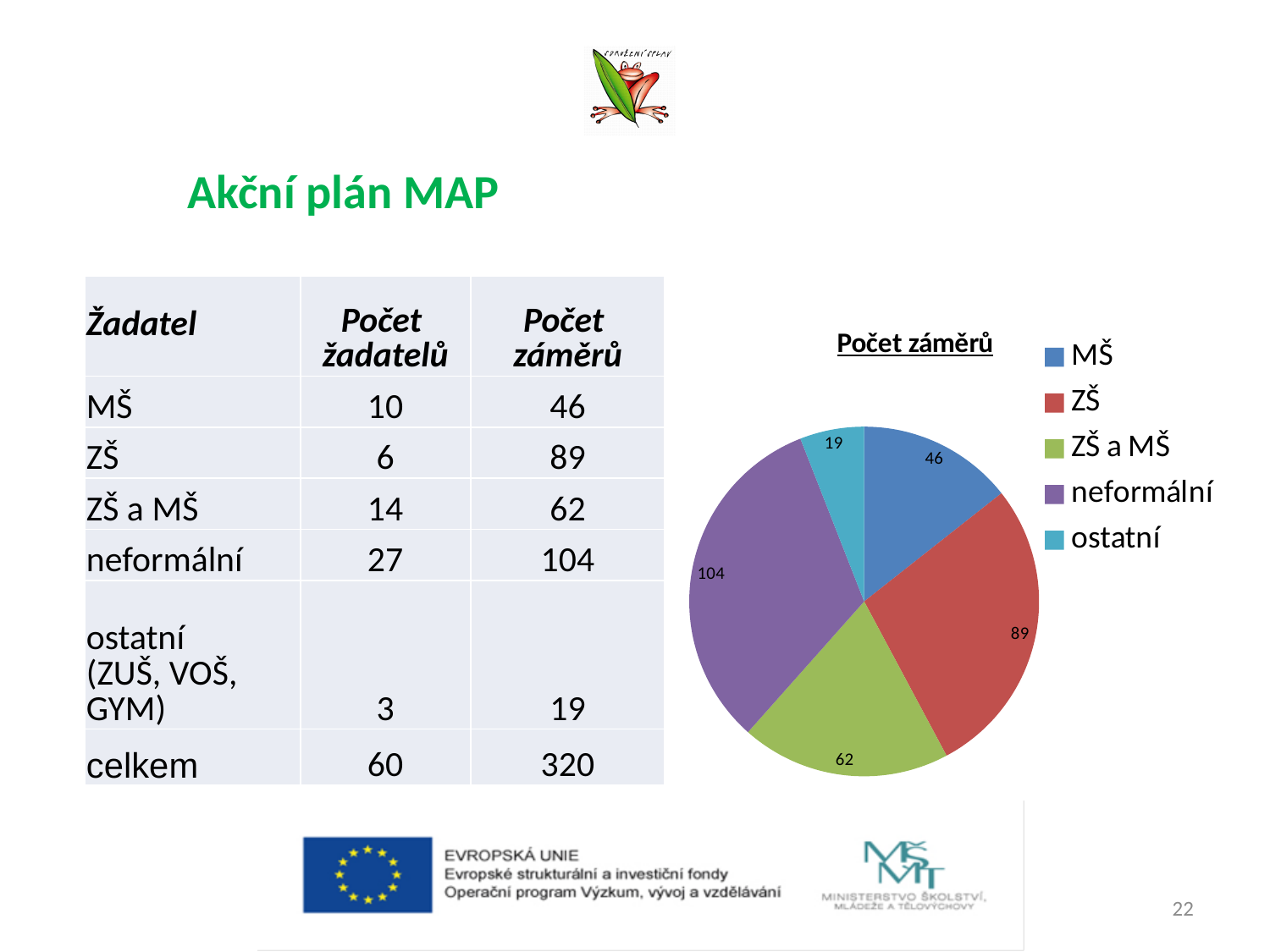
What is the title of the chart? Počet záměrů What share of the pie does the neformální slice represent? 32.5% What is the difference between the ZŠ slice and the ZŠ a MŠ slice? 27 What type of chart is shown on the slide? pie chart Which category has the smallest slice in the pie chart? ostatní Which slice is larger, ZŠ or MŠ? ZŠ How many entries does the chart legend list? 5 How many slices does the pie chart have? 5 What is the value of the ostatní slice in the pie chart? 19 What is the value of the MŠ slice in the pie chart? 46 What is the value of the neformální slice in the pie chart? 104 Which category has the largest slice in the pie chart? neformální